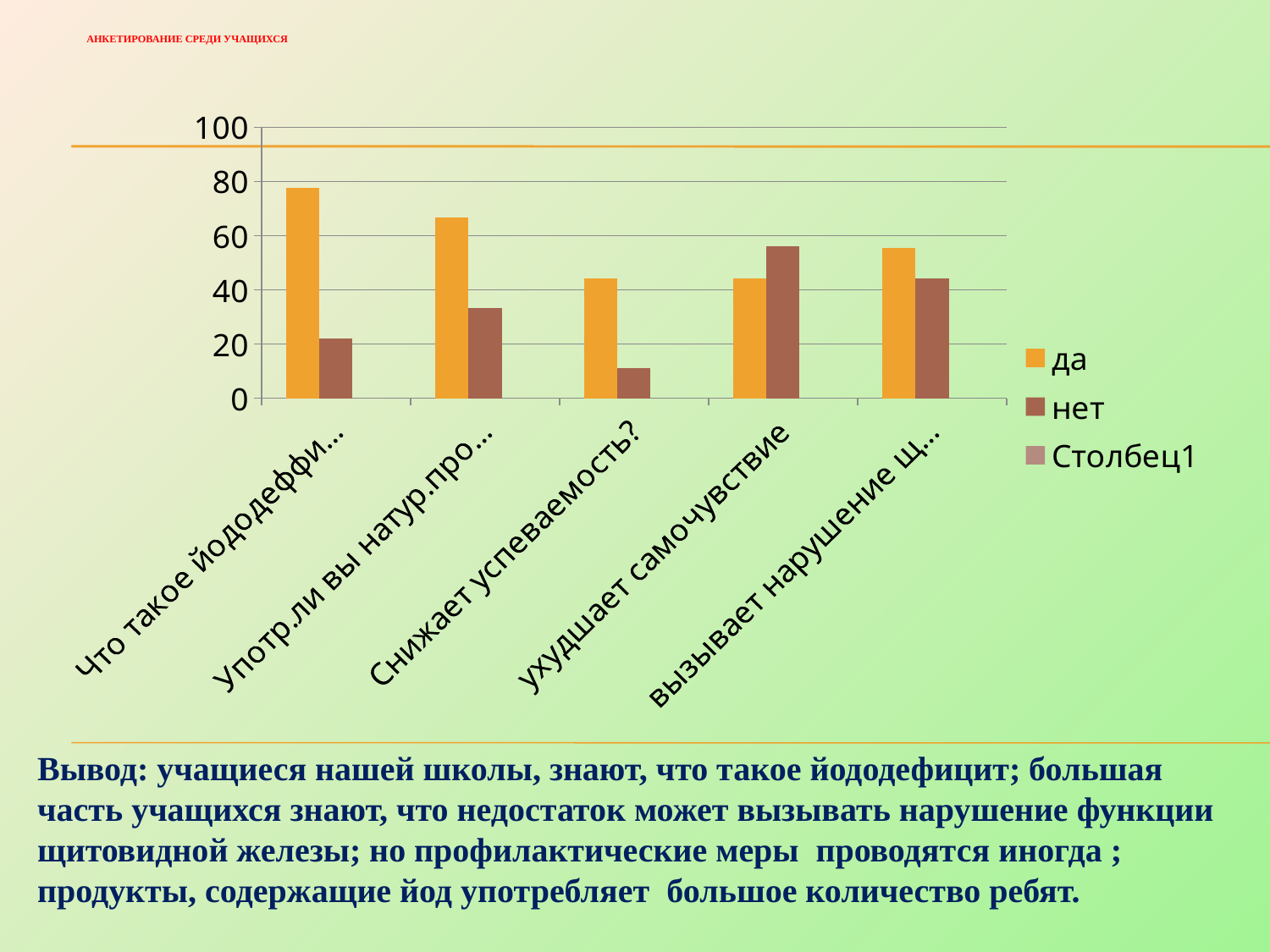
Which category has the highest value for the series 'нет'? ухудшает самочувствие What are the entries in the chart's legend? да, нет, Столбец1 Is the value of 'нет' for 'Снижает успеваемость?' greater or less than 20? less For 'ухудшает самочувствие', which is larger: the value for 'да' or for 'нет'? нет What kind of chart is shown on the slide? bar chart Which category has the highest value for the series 'да'? the first category from the left Is the value of 'да' for 'Снижает успеваемость?' greater or less than 60? less Is the value of 'нет' for 'ухудшает самочувствие' greater or less than 40? greater Which category has the lowest value for the series 'нет'? Снижает успеваемость? What colour are the bars for the series 'да'? orange How many categories are shown along the x axis? 5 How many series does the legend list? 3